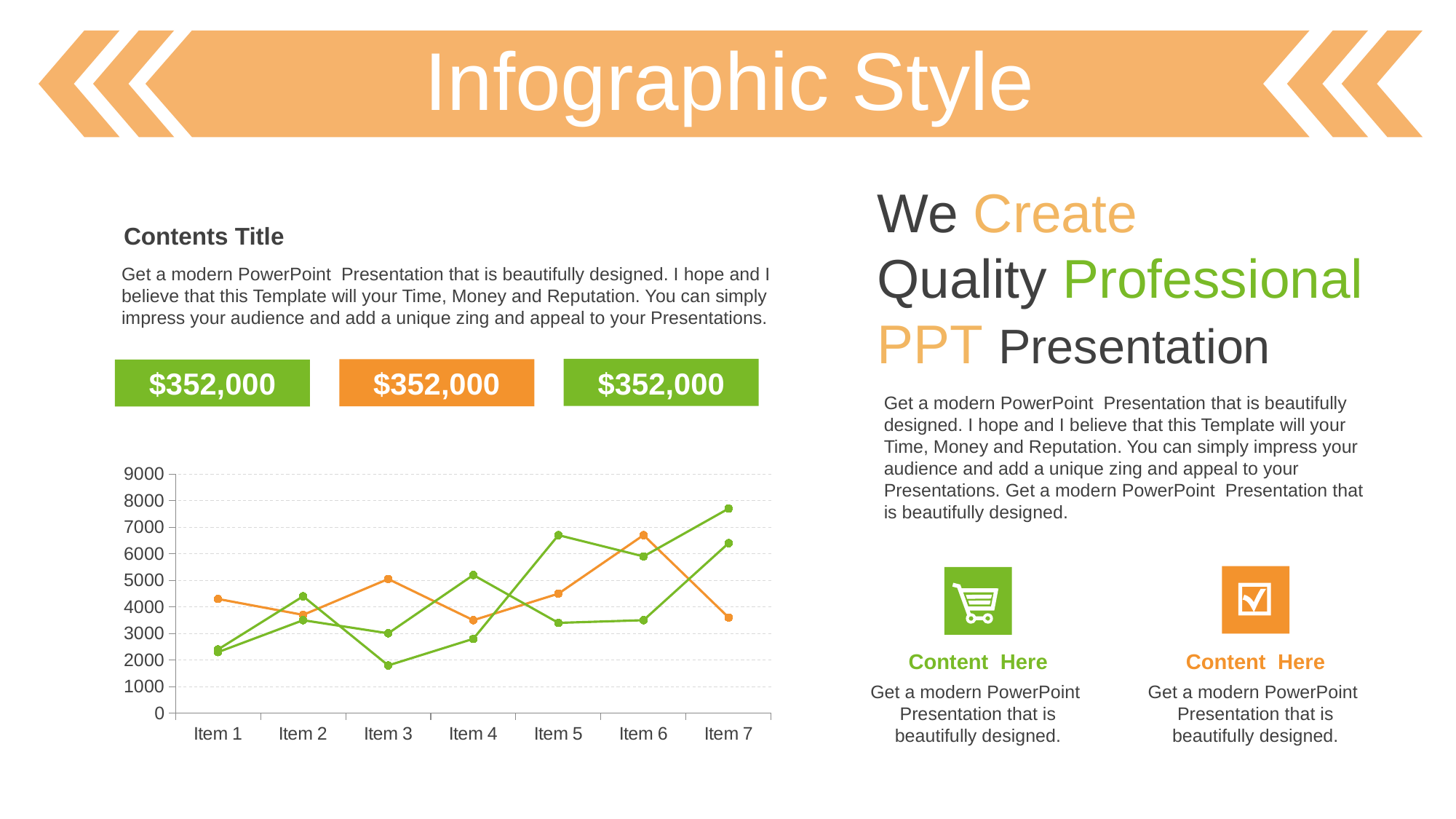
Is the value of the orange line at Item 4 greater or less than 4000? less Is the highest point plotted at Item 7 greater or less than 7000? greater What is the highest value shown on the y axis of the line chart? 9000 At which item does the orange line reach its highest value? Item 6 Is the value of the orange line at Item 1 greater or less than 4000? greater What colours are the lines in the chart? green and orange What kind of chart is shown on the slide? line chart How many categories are shown on the x axis of the line chart? 7 Which is larger at Item 6: the orange line or the lower green line? the orange line How many lines are plotted in the line chart? 3